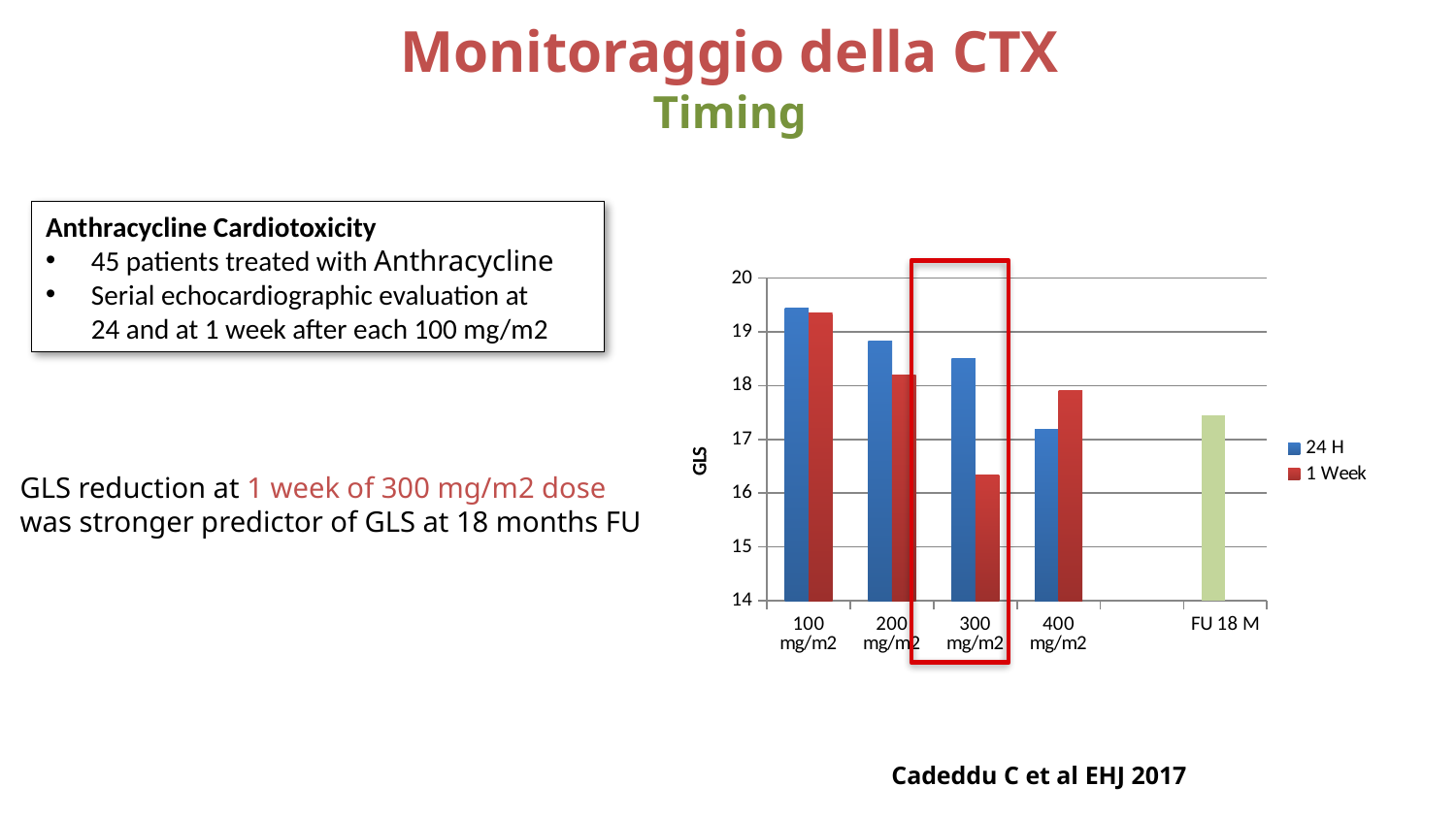
Is the 1 Week value for 300 mg/m2 greater or less than 17? less How many categories are shown on the x axis of the chart? 5 Which category has the lowest 1 Week value? 300 mg/m2 How many series does the chart legend list? 2 At 300 mg/m2, which is larger: the 24 H value or the 1 Week value? 24 H Which category has the highest 24 H value? 100 mg/m2 Is the 24 H value for 400 mg/m2 greater or less than 18? less What kind of chart is shown on the slide? bar chart Do the 24 H values rise or fall from 100 mg/m2 to 400 mg/m2? fall Is the 1 Week value for 200 mg/m2 greater or less than 18? greater At 400 mg/m2, which is larger: the 24 H value or the 1 Week value? 1 Week